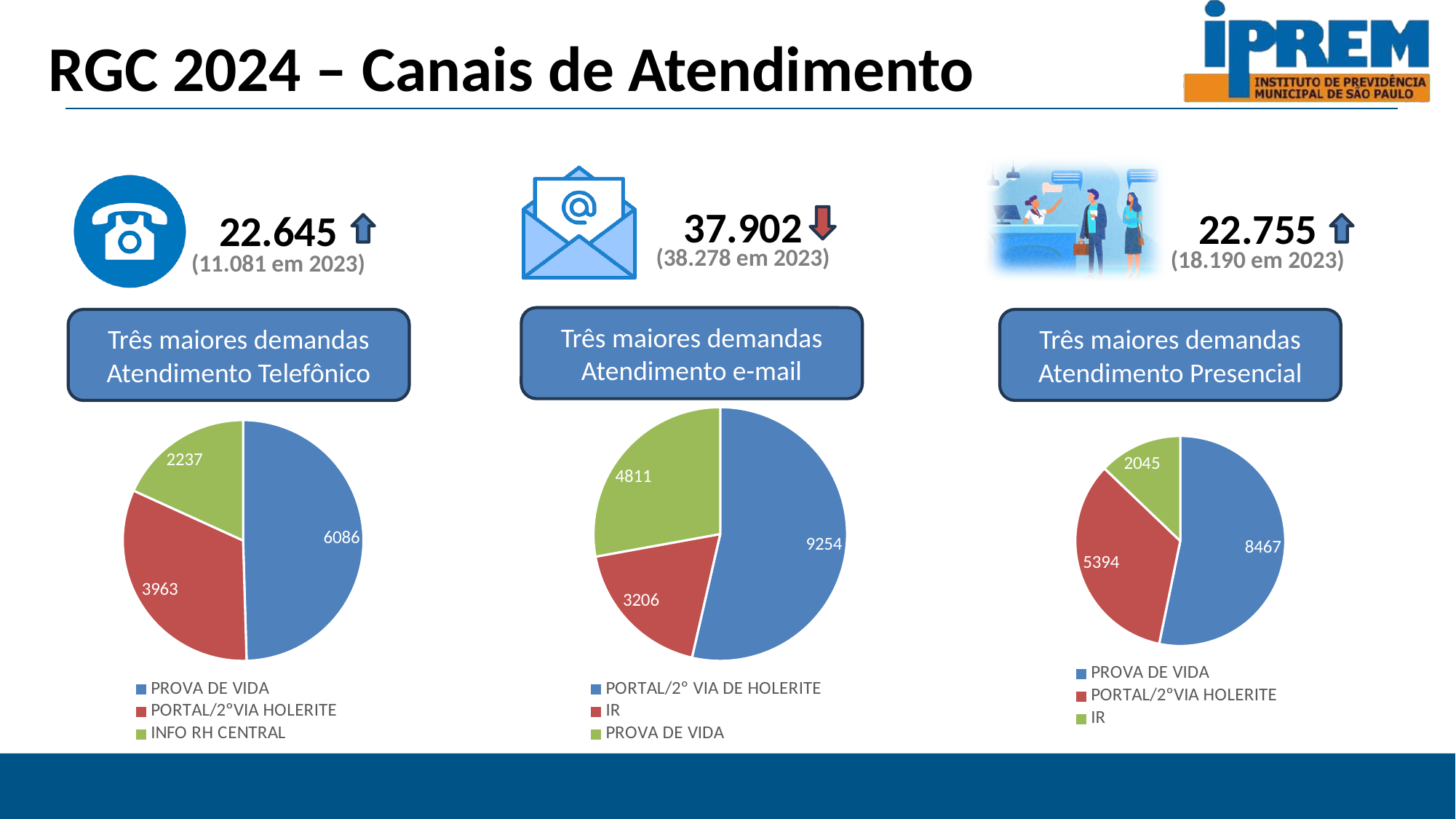
In the 'Três maiores demandas Atendimento e-mail' pie chart, what is the difference between PORTAL/2° VIA DE HOLERITE and PROVA DE VIDA? 4443 In the 'Três maiores demandas Atendimento Telefônico' pie chart, what is the value for INFO RH CENTRAL? 2237 How many slices does the 'Três maiores demandas Atendimento e-mail' pie chart have? 3 In the 'Três maiores demandas Atendimento Telefônico' pie chart, what colour is the INFO RH CENTRAL slice? Green In the 'Três maiores demandas Atendimento Telefônico' pie chart, what is the difference between PROVA DE VIDA and PORTAL/2ªVIA HOLERITE? 2123 In the 'Três maiores demandas Atendimento e-mail' pie chart, what is the value for IR? 3206 In the 'Três maiores demandas Atendimento Presencial' pie chart, which category has the smallest slice? IR What kind of chart is used for 'Três maiores demandas Atendimento Presencial'? Pie chart In the 'Três maiores demandas Atendimento e-mail' pie chart, which category has the largest slice? PORTAL/2° VIA DE HOLERITE In the 'Três maiores demandas Atendimento Presencial' pie chart, which is larger: PROVA DE VIDA or IR? PROVA DE VIDA In the 'Três maiores demandas Atendimento Telefônico' pie chart, what is the value for PROVA DE VIDA? 6086 In the 'Três maiores demandas Atendimento Presencial' pie chart, what is the value for PORTAL/2°VIA HOLERITE? 5394